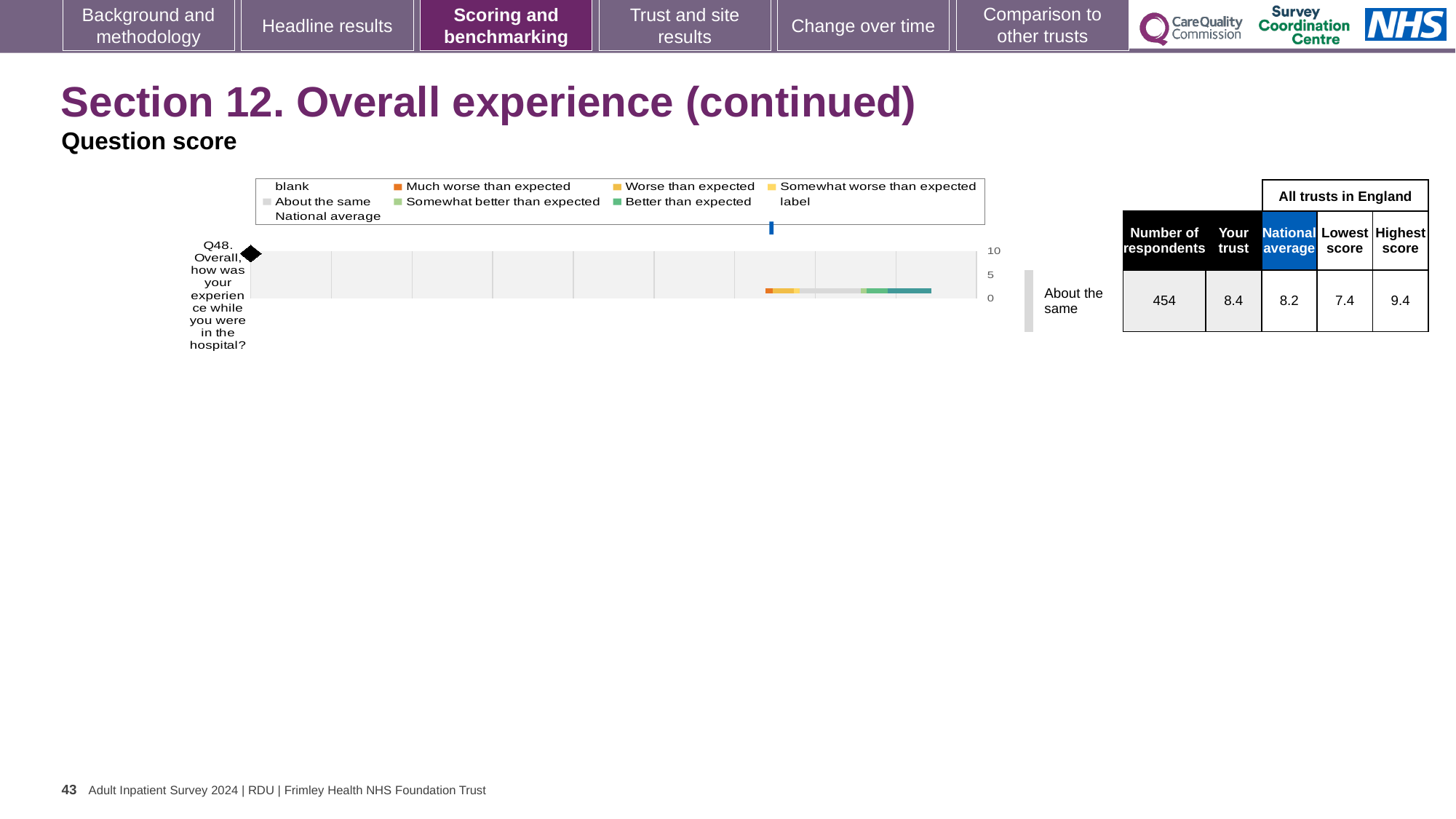
What is the 'Your trust' score for Q48? 8.4 What is the difference between the highest and lowest scores for Q48 across all trusts in England? 2.0 Which benchmarking category is the trust's Q48 score placed in? About the same How many survey questions are plotted on the chart? 1 How many respondents answered Q48? 454 Which is larger for Q48, the 'Your trust' score or the national average? Your trust What is the highest score among all trusts in England for Q48? 9.4 Which question is plotted on the chart? Q48. Overall, how was your experience while you were in the hospital? What is the national average score for Q48? 8.2 What kind of chart is shown on the slide? bar chart What is the difference between the 'Your trust' score and the national average for Q48? 0.2 What is the lowest score among all trusts in England for Q48? 7.4